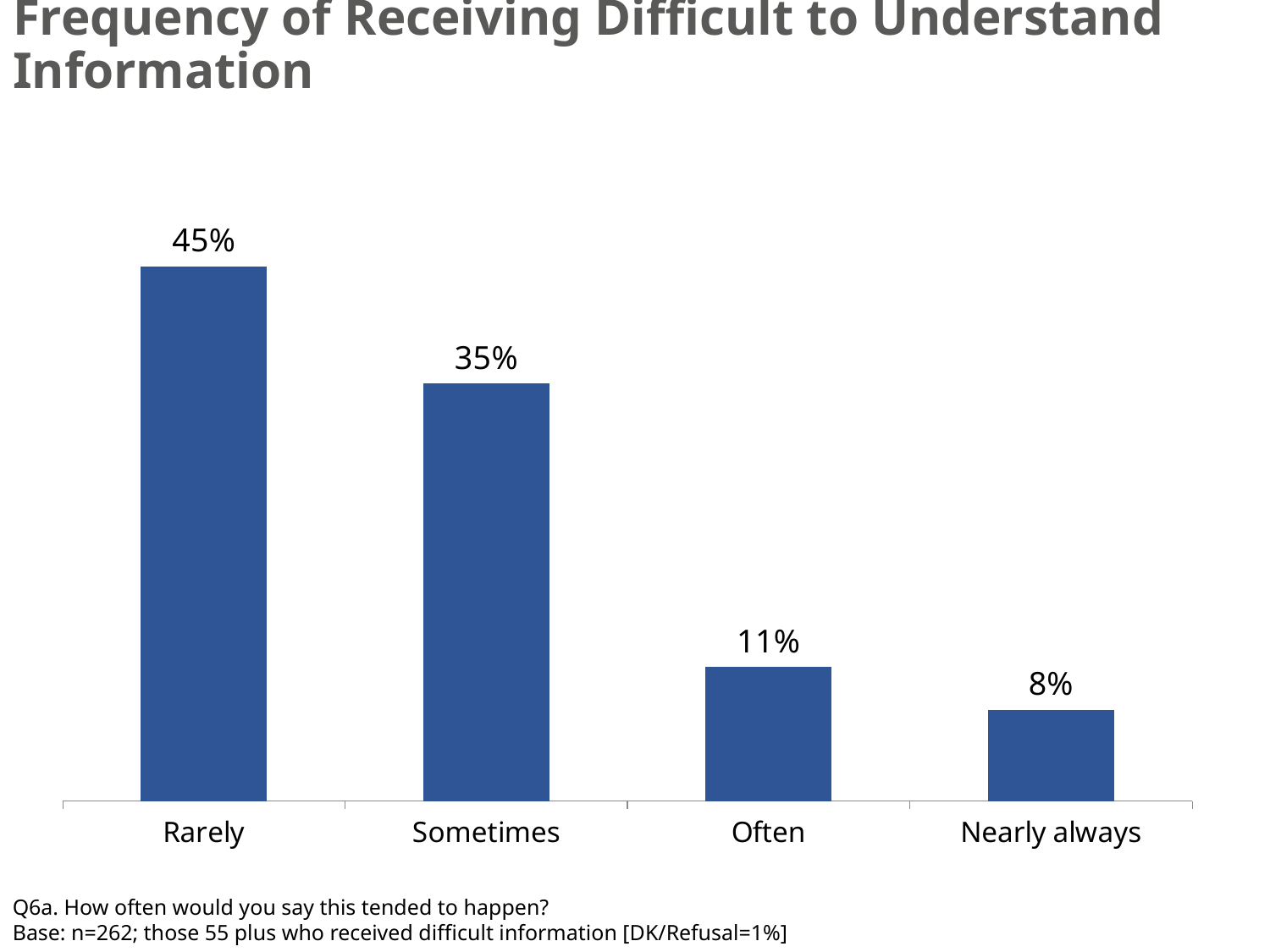
Do the values rise or fall moving from left to right along the x axis? Fall What is the value shown for the 'Nearly always' category? 8% Which is larger, the value for 'Sometimes' or the value for 'Often'? Sometimes Which category has the lowest value? Nearly always How many categories are shown on the x axis? 4 What is the value shown for the 'Often' category? 11% What is the difference in percentage points between 'Often' and 'Nearly always'? 3 percentage points What is the difference in percentage points between 'Rarely' and 'Sometimes'? 10 percentage points What percentage of respondents said they rarely received difficult to understand information? 45% What kind of chart is shown on the slide? Bar chart Which category has the highest value? Rarely What is the value shown for the 'Sometimes' category? 35%